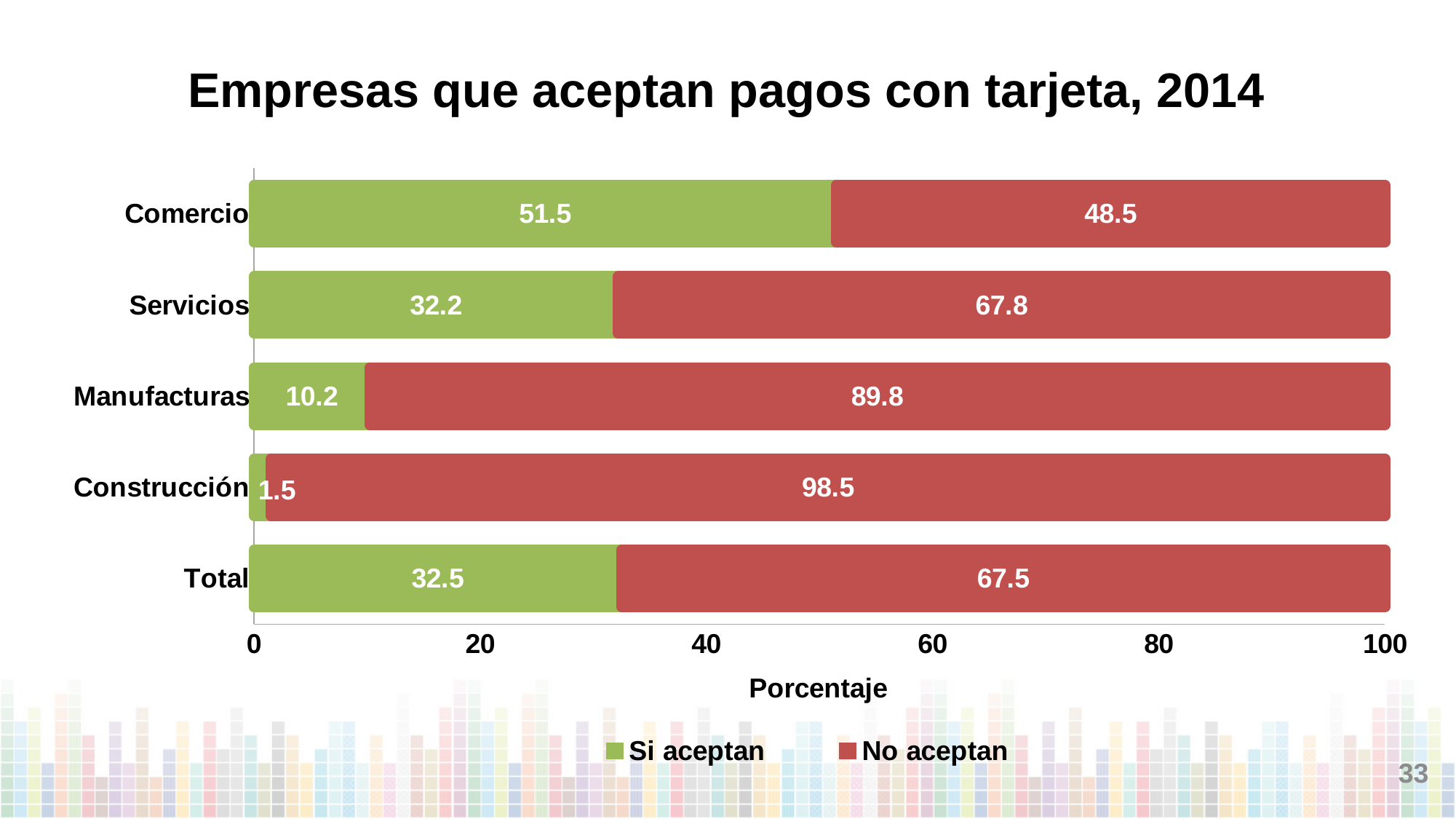
Is the 'No aceptan' value for Comercio greater or less than 60? less How many series does the legend list? 2 What is the total of the stacked bar for Manufacturas? 100 What is the 'Si aceptan' value for Comercio? 51.5 What is the difference between the 'No aceptan' and 'Si aceptan' values for Servicios? 35.6 Which category has the lowest 'No aceptan' value? Comercio Which category has the highest 'Si aceptan' value? Comercio How many categories are shown on the y axis? 5 What is the 'No aceptan' value for Manufacturas? 89.8 What is the 'Si aceptan' value for Construcción? 1.5 Which is larger: the 'Si aceptan' value for Servicios or for Total? Total What kind of chart is shown on the slide? Stacked bar chart